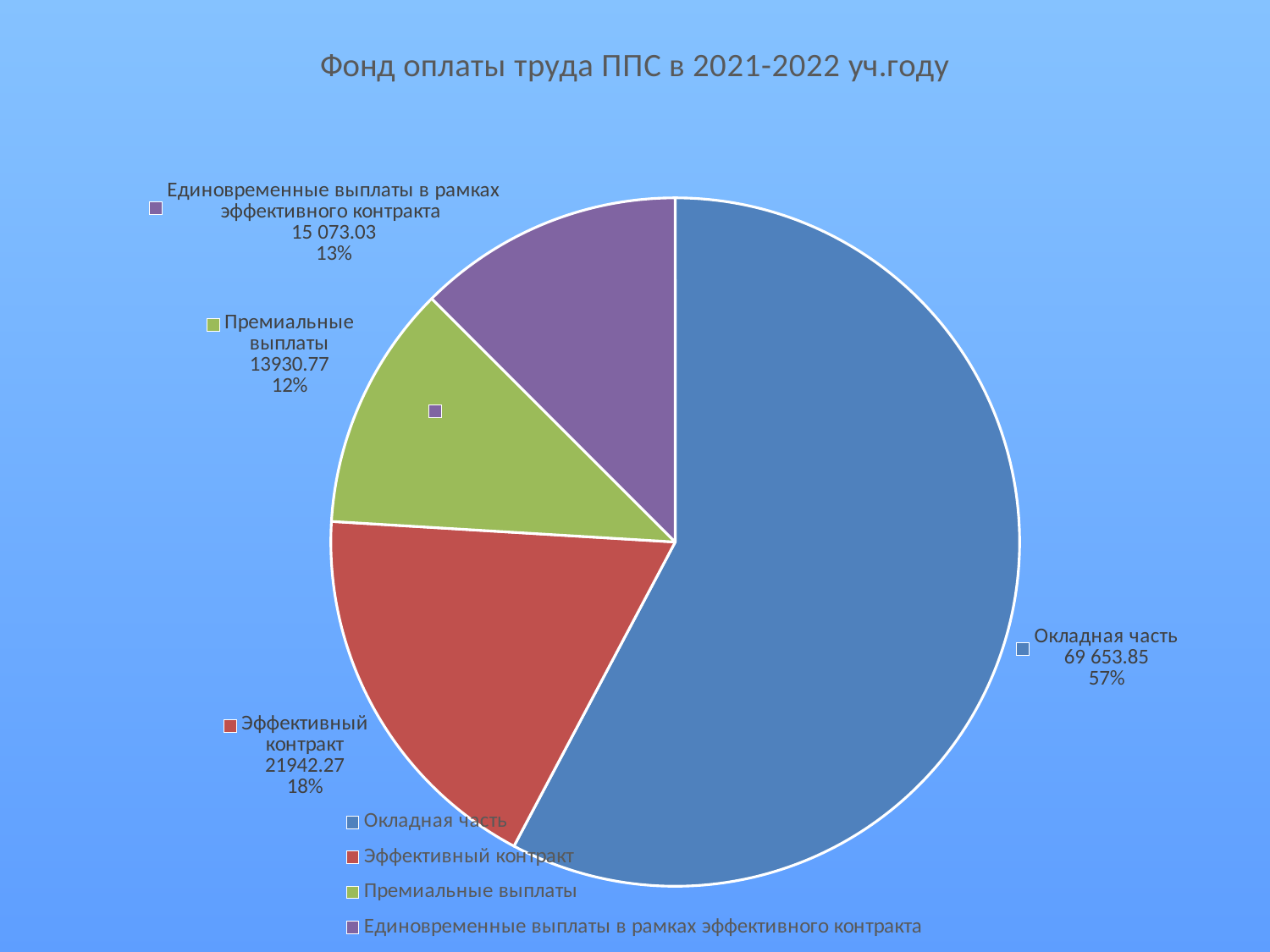
Which category has the largest slice? Окладная часть Which category has the smallest slice? Премиальные выплаты What share of the pie does Премиальные выплаты represent? 12% How many slices does the pie chart have? 4 What is the difference between the values for Окладная часть and Эффективный контракт? 47711.58 What is the title of the chart? Фонд оплаты труда ППС в 2021-2022 уч.году What share of the pie does Окладная часть represent? 57% What is the value for Премиальные выплаты? 13930.77 What type of chart is shown on the slide? pie chart What is the value for Окладная часть? 69 653.85 What is the value for Единовременные выплаты в рамках эффективного контракта? 15 073.03 What is the value for Эффективный контракт? 21942.27